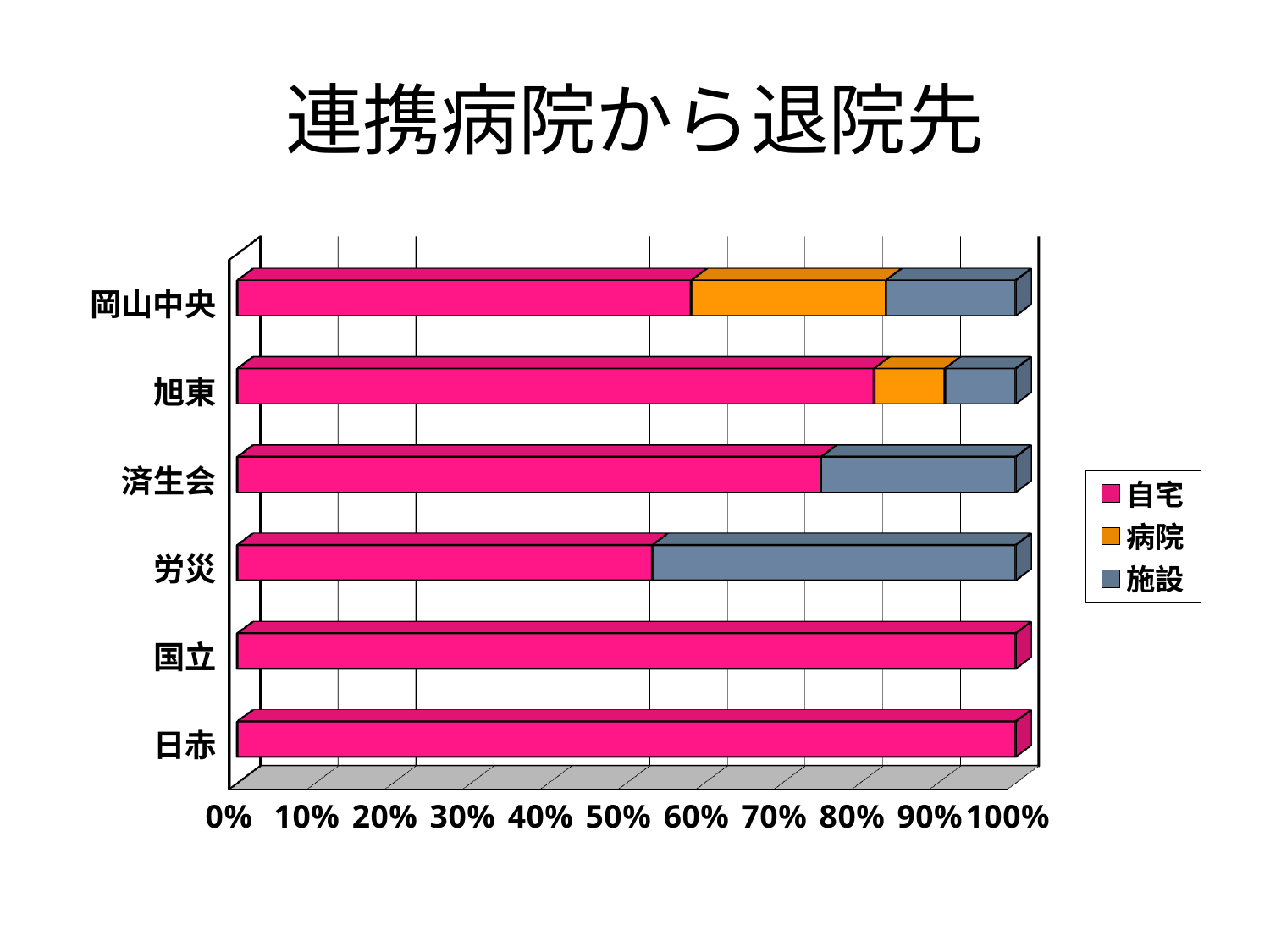
Is the 自宅 value for 旭東 greater or less than 70%? greater Which hospital has the largest 病院 segment? 岡山中央 What is the title of the chart? 連携病院から退院先 What kind of chart is shown on the slide? bar chart Is the 自宅 value for 済生会 greater or less than 70%? greater Is the 自宅 value for 労災 greater or less than 60%? less Which legend entry is shown in orange? 病院 Which hospital has the largest 施設 segment? 労災 How many hospitals (categories) are shown on the chart? 6 How many series does the legend list? 3 What is the 自宅 share for 日赤? 100% What is the 自宅 share for 国立? 100%